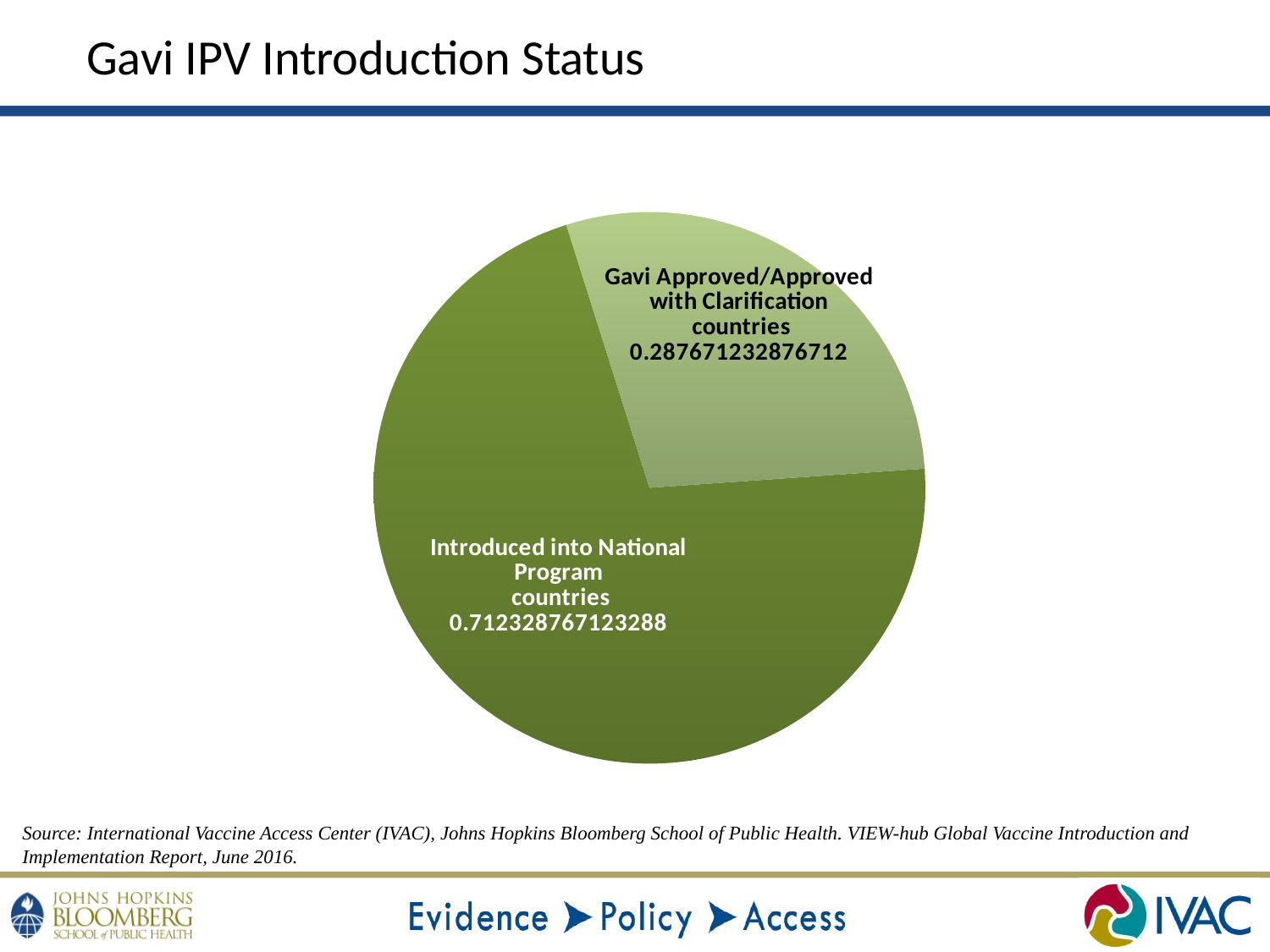
Which slice is shown in the lighter green colour? Gavi Approved/Approved with Clarification countries Which slice of the pie is the smallest? Gavi Approved/Approved with Clarification countries How many slices does the pie chart have? 2 What is the title of the slide containing the pie chart? Gavi IPV Introduction Status What kind of chart is shown on the slide? pie chart What is the value shown for the Gavi Approved/Approved with Clarification countries slice? 0.287671232876712 Which is larger: the Introduced into National Program countries slice or the Gavi Approved/Approved with Clarification countries slice? Introduced into National Program countries Which slice of the pie is the largest? Introduced into National Program countries What is the value shown for the Introduced into National Program countries slice? 0.712328767123288